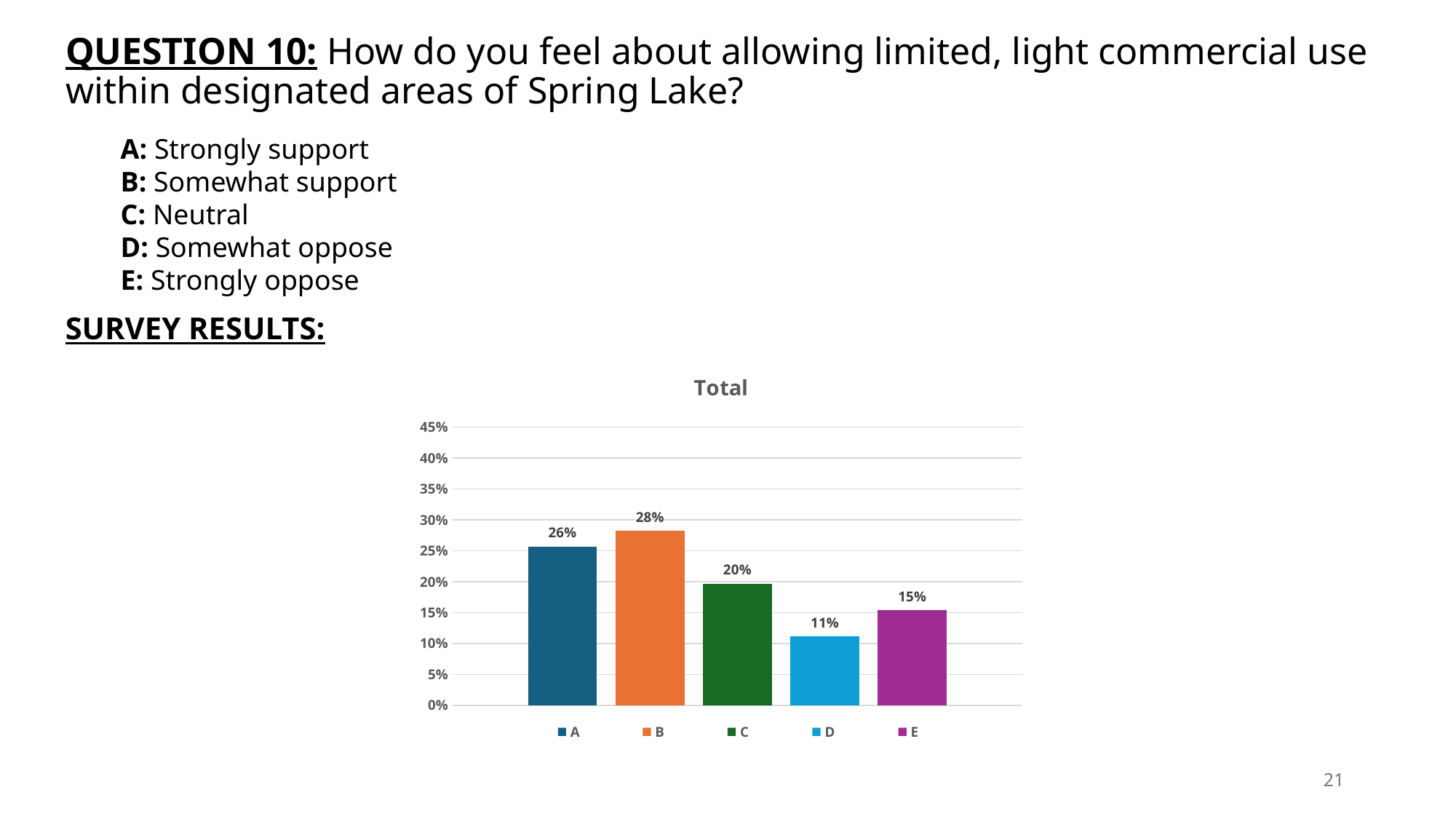
What is the difference between the values for A and C? 6% What is the title of the chart? Total What is the highest value shown on the vertical axis? 45% What is the value for category E? 15% Which category has the highest value? B Is the value for A greater or less than 20%? greater What kind of chart is shown on the slide? bar chart What is the value for category D? 11% What is the value for category B? 28% Which is larger, the value for C or the value for E? C Which category has the lowest value? D How many categories are shown in the chart? 5